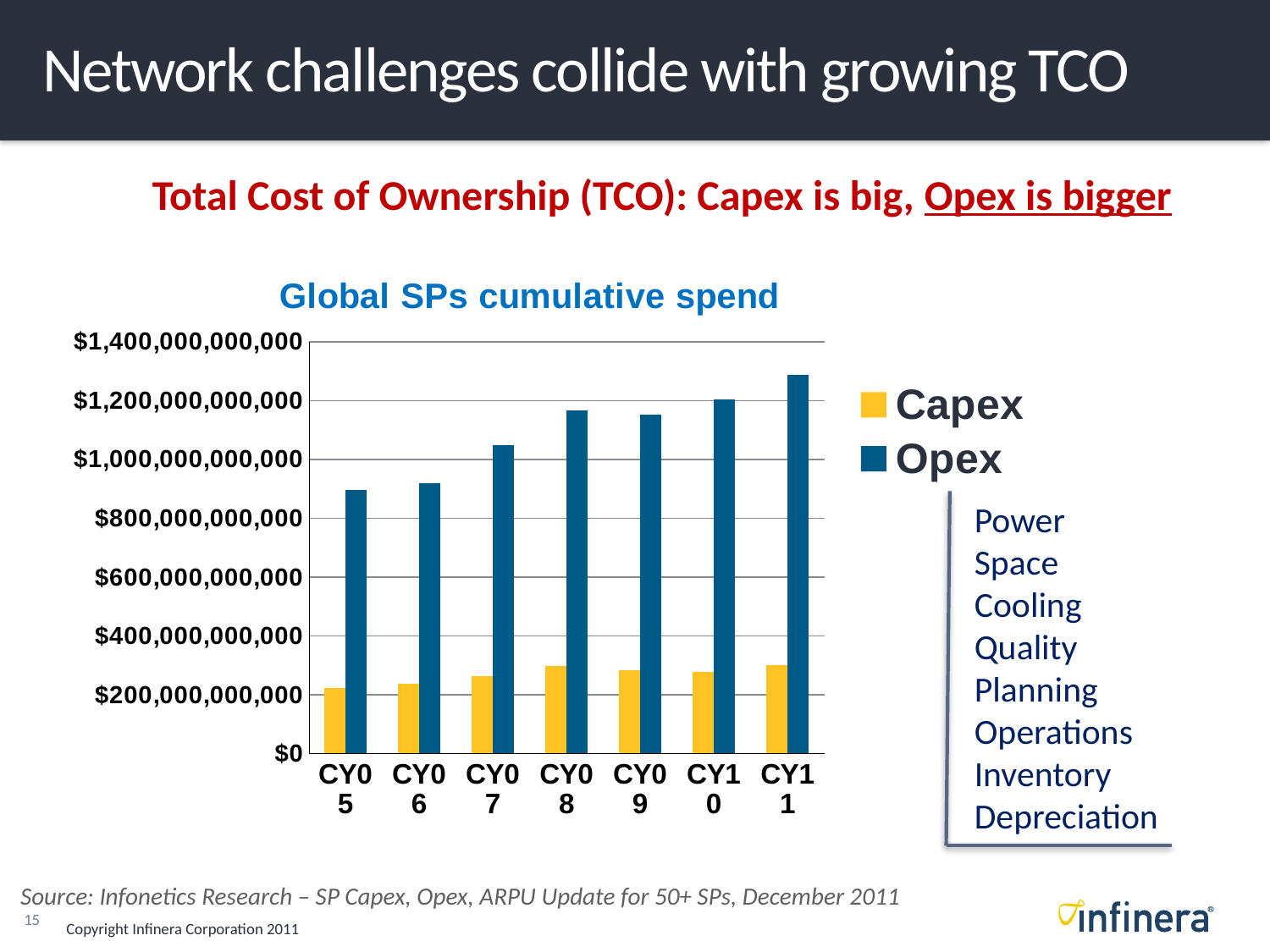
How many years (categories) are shown on the x axis of the chart? 7 Which year has the lowest Opex value in the chart? CY05 Which year has the lowest Capex value in the chart? CY05 Is the Capex value for CY08 greater or less than $400,000,000,000? less Is the Opex value for CY11 greater or less than $1,200,000,000,000? greater In CY08, which is larger, Capex or Opex? Opex What is the title of the chart? Global SPs cumulative spend Which year has the highest Opex value in the chart? CY11 Which colour represents Opex in the chart? Blue Is the Opex value for CY05 greater or less than $1,000,000,000,000? less How many series does the chart's legend list? 2 What kind of chart is shown on the slide? Bar chart